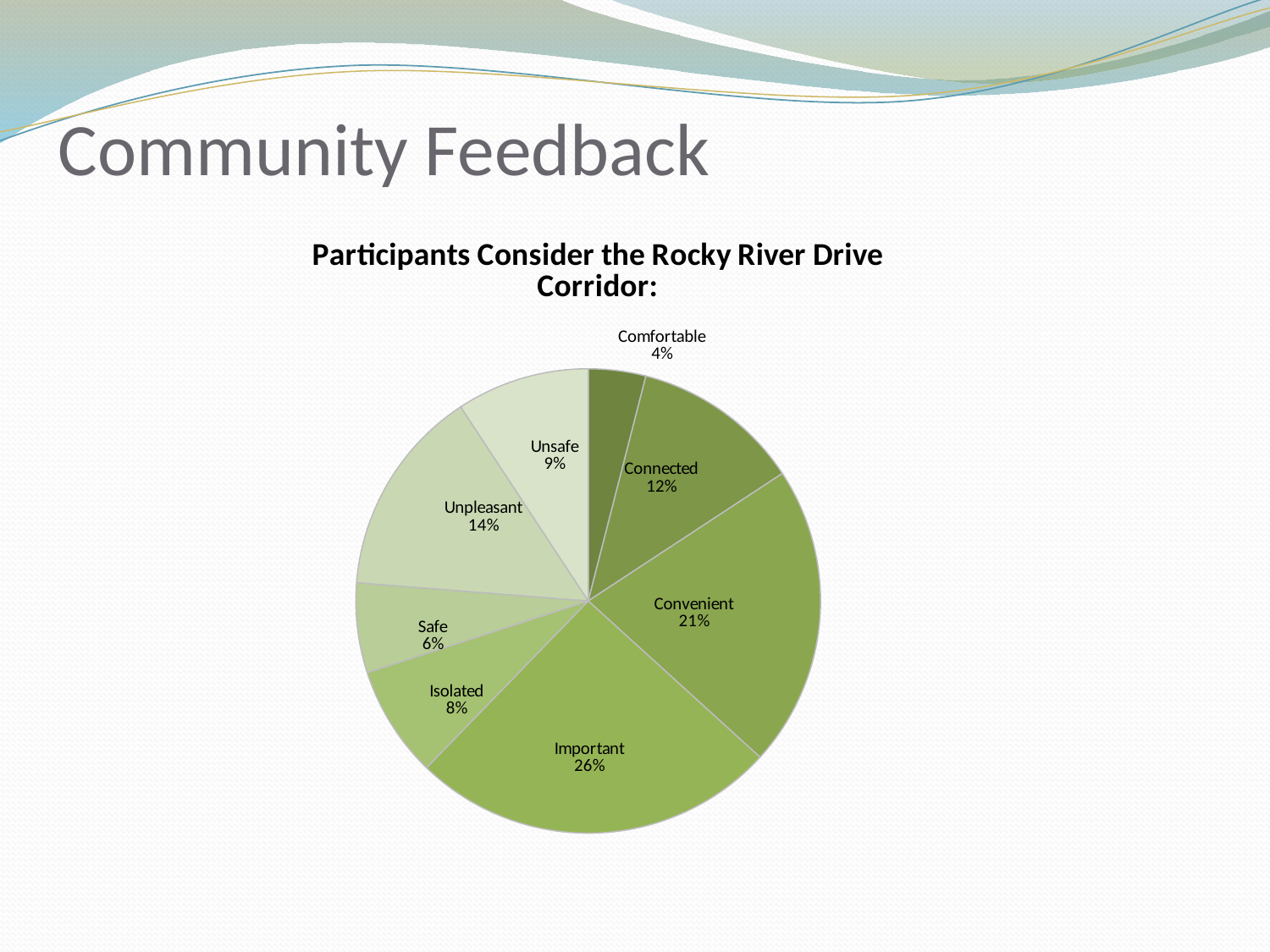
Which category has the largest slice of the pie? Important What is the difference in percentage points between Important and Convenient? 5 What percentage is shown for Comfortable? 4% Which is larger, the share for Unsafe or the share for Safe? Unsafe What percentage of participants consider the Rocky River Drive Corridor Important? 26% What percentage is shown for Unpleasant? 14% What is the combined percentage for Connected and Isolated? 20% What share of the pie is labelled Convenient? 21% What is the title of the chart? Participants Consider the Rocky River Drive Corridor: How many categories are shown in the pie chart? 8 What kind of chart is shown on the slide? Pie chart Which category has the smallest slice of the pie? Comfortable